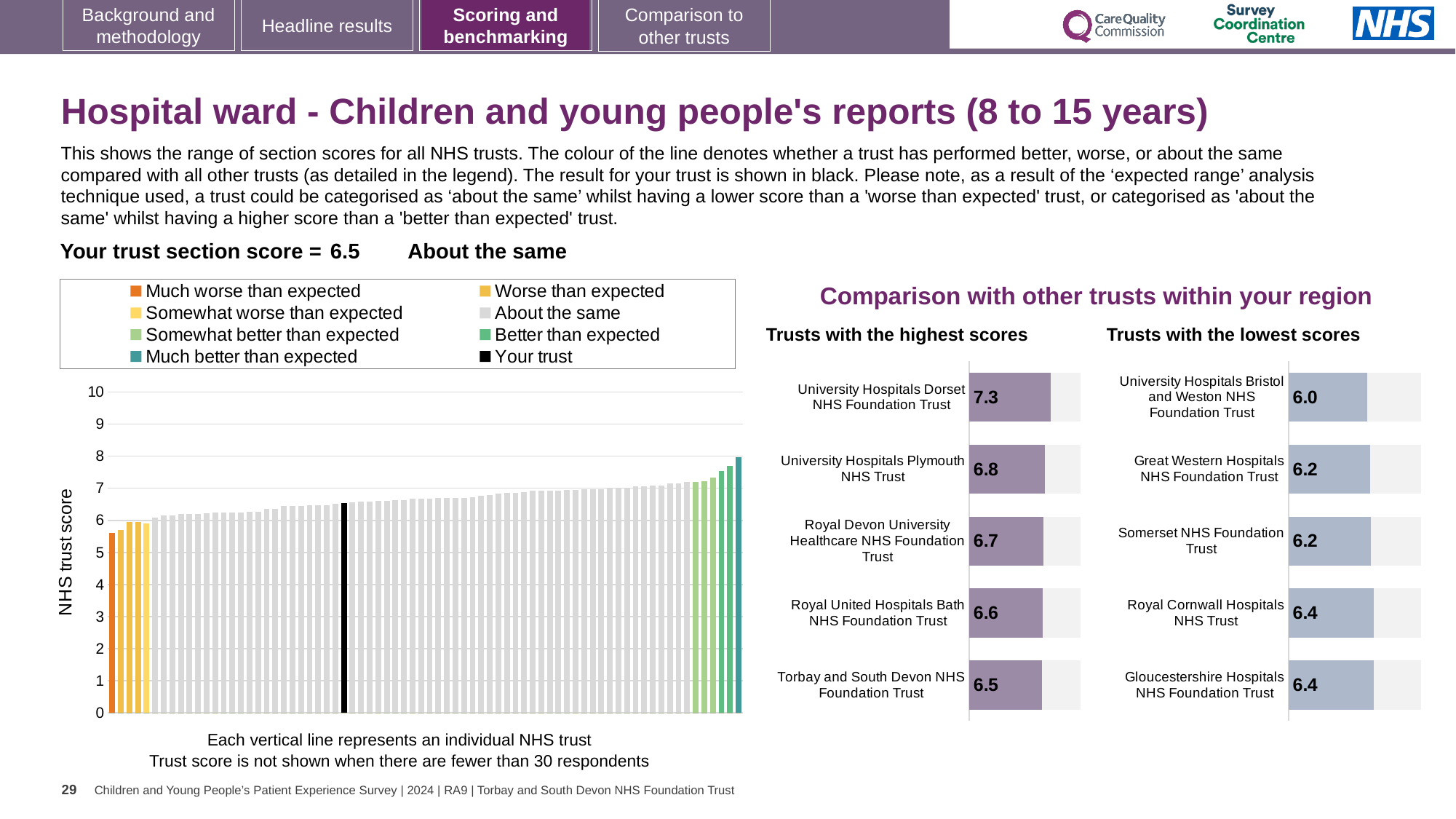
In the 'Trusts with the lowest scores' chart, what is the score for University Hospitals Bristol and Weston NHS Foundation Trust? 6.0 How many entries does the legend of the large chart on the left list? 8 In the 'Trusts with the highest scores' chart, which trust has the highest score? University Hospitals Dorset NHS Foundation Trust In the 'Trusts with the highest scores' chart, what is the score for Royal Devon University Healthcare NHS Foundation Trust? 6.7 What kind of chart is the large chart on the left with the 'NHS trust score' axis? Bar chart How many trusts are shown in the 'Trusts with the lowest scores' chart? 5 In the 'Trusts with the highest scores' chart, what is the score for University Hospitals Dorset NHS Foundation Trust? 7.3 In the large chart on the left, do the trust scores rise or fall from left to right? Rise In the 'Trusts with the lowest scores' chart, which trust has the lowest score? University Hospitals Bristol and Weston NHS Foundation Trust In the 'Trusts with the lowest scores' chart, what is the difference between the scores of Gloucestershire Hospitals NHS Foundation Trust and University Hospitals Bristol and Weston NHS Foundation Trust? 0.4 In the 'Trusts with the highest scores' chart, what is the difference between the scores of University Hospitals Dorset NHS Foundation Trust and Torbay and South Devon NHS Foundation Trust? 0.8 In the 'Trusts with the lowest scores' chart, which has the larger score: Great Western Hospitals NHS Foundation Trust or Royal Cornwall Hospitals NHS Trust? Royal Cornwall Hospitals NHS Trust